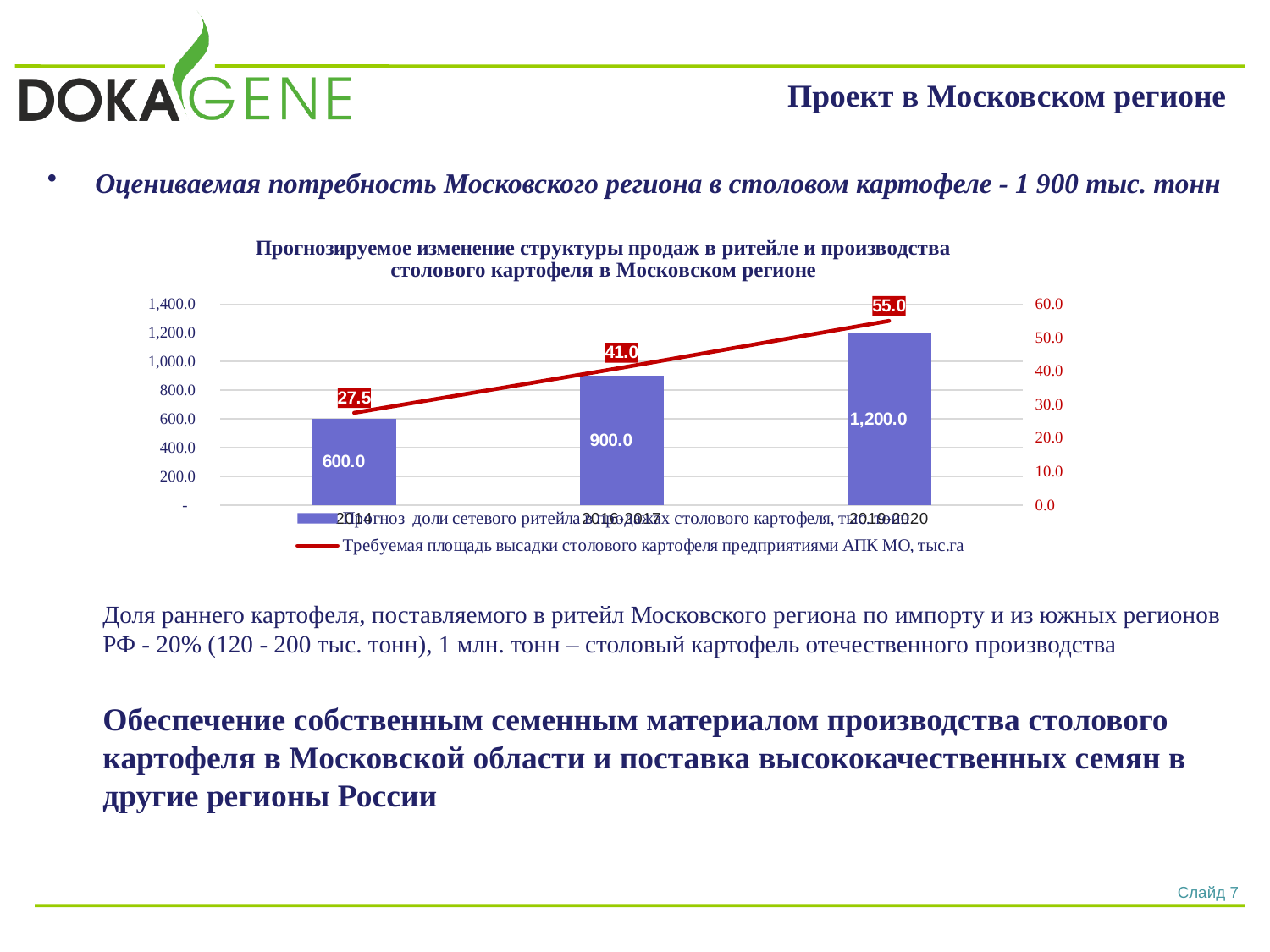
What is the difference between the bar values for the last category (1,200.0) and the first category (600.0)? 600.0 Which category has the highest bar value? 2019-2020 How many series does the legend list? 2 What is the value of the bar for the first category (2014)? 600.0 What is the difference between the line values 55.0 and 27.5? 27.5 How many categories are shown on the x axis? 3 What is the value of the bar for the last category (2019-2020)? 1,200.0 Do the bar values rise or fall from left to right along the x axis? rise What is the value of the middle bar (2016-2017)? 900.0 What is the line value (required planting area, thousand ha) for the first category (2014)? 27.5 What is the line value (required planting area, thousand ha) for the last category (2019-2020)? 55.0 Which category has the lowest line value? 2014